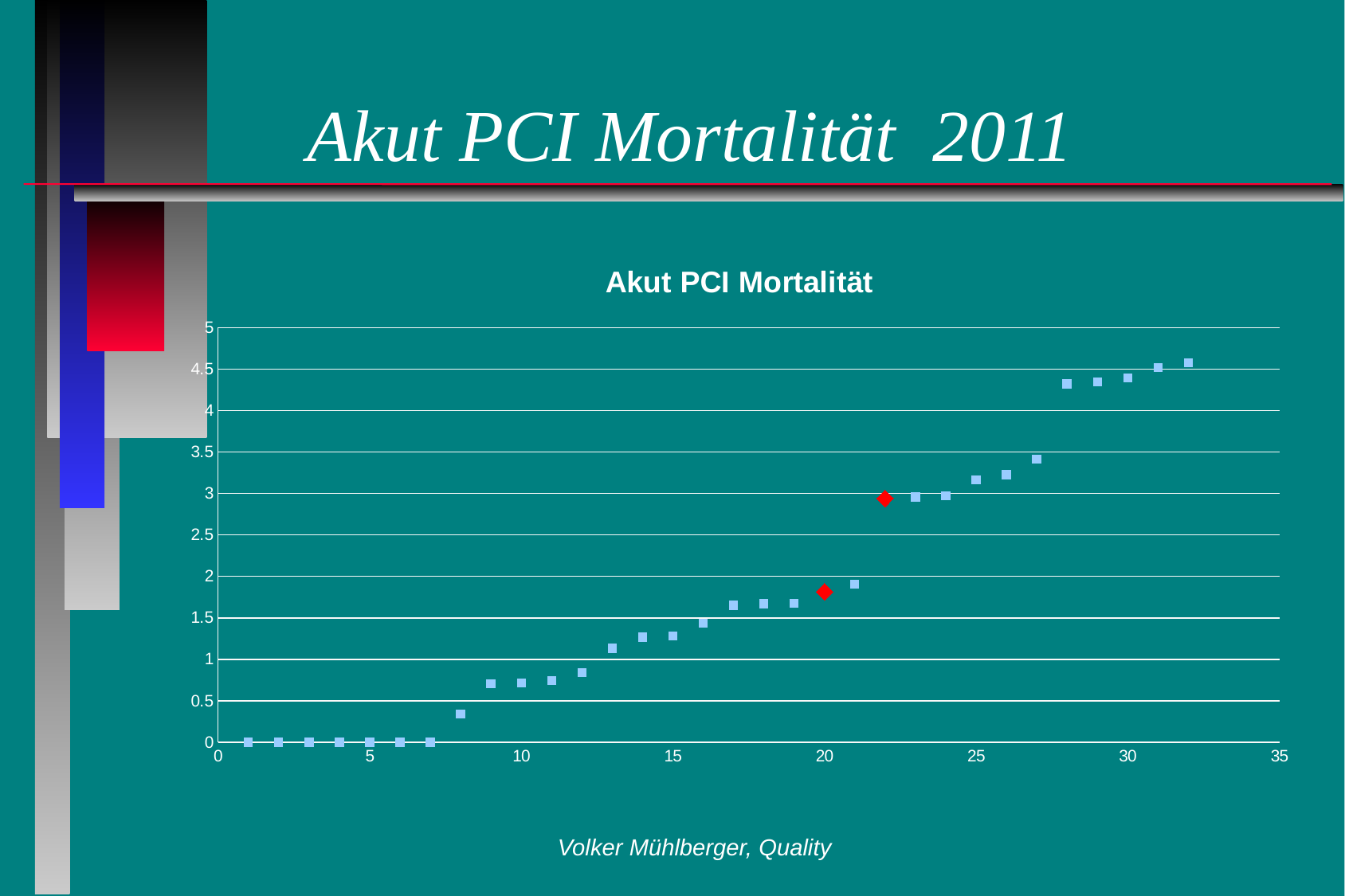
What kind of chart is shown on the slide? scatter chart How many red diamond markers are shown in the chart? 2 At which x value is the highest plotted point? 32 Is the value for x = 28 greater or less than 4? greater How many plotted points have a value of 0? 7 Do the plotted values rise or fall as the x value increases? rise How many data points are plotted in the chart? 32 Is the value for x = 8 greater or less than 0.5? less Is the value of the red diamond at x = 20 greater or less than 2? less Which has the larger value, the point at x = 30 or the point at x = 10? x = 30 What is the title of the chart? Akut PCI Mortalität